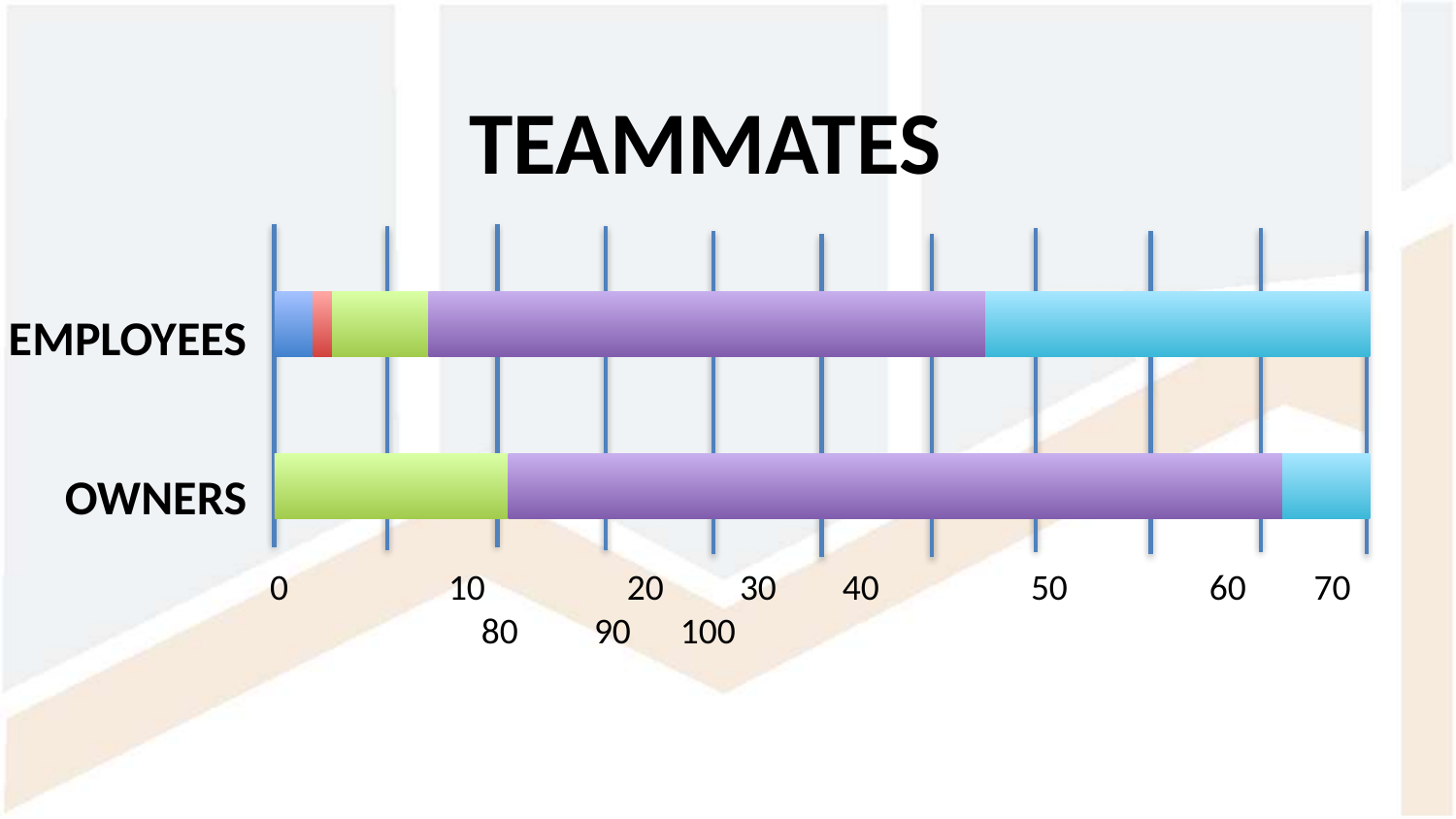
Are the bars in the chart drawn horizontally or vertically? Horizontally Which category has the larger purple segment, EMPLOYEES or OWNERS? OWNERS What are the two categories shown in the chart? EMPLOYEES and OWNERS Which category's bar contains a red segment? EMPLOYEES What is the title of the chart? TEAMMATES Which category's bar has more segments, EMPLOYEES or OWNERS? EMPLOYEES How many coloured segments make up the OWNERS bar? 3 How many categories are shown on the vertical axis of the chart? 2 How many coloured segments make up the EMPLOYEES bar? 5 What kind of chart is shown on the slide? Stacked bar chart